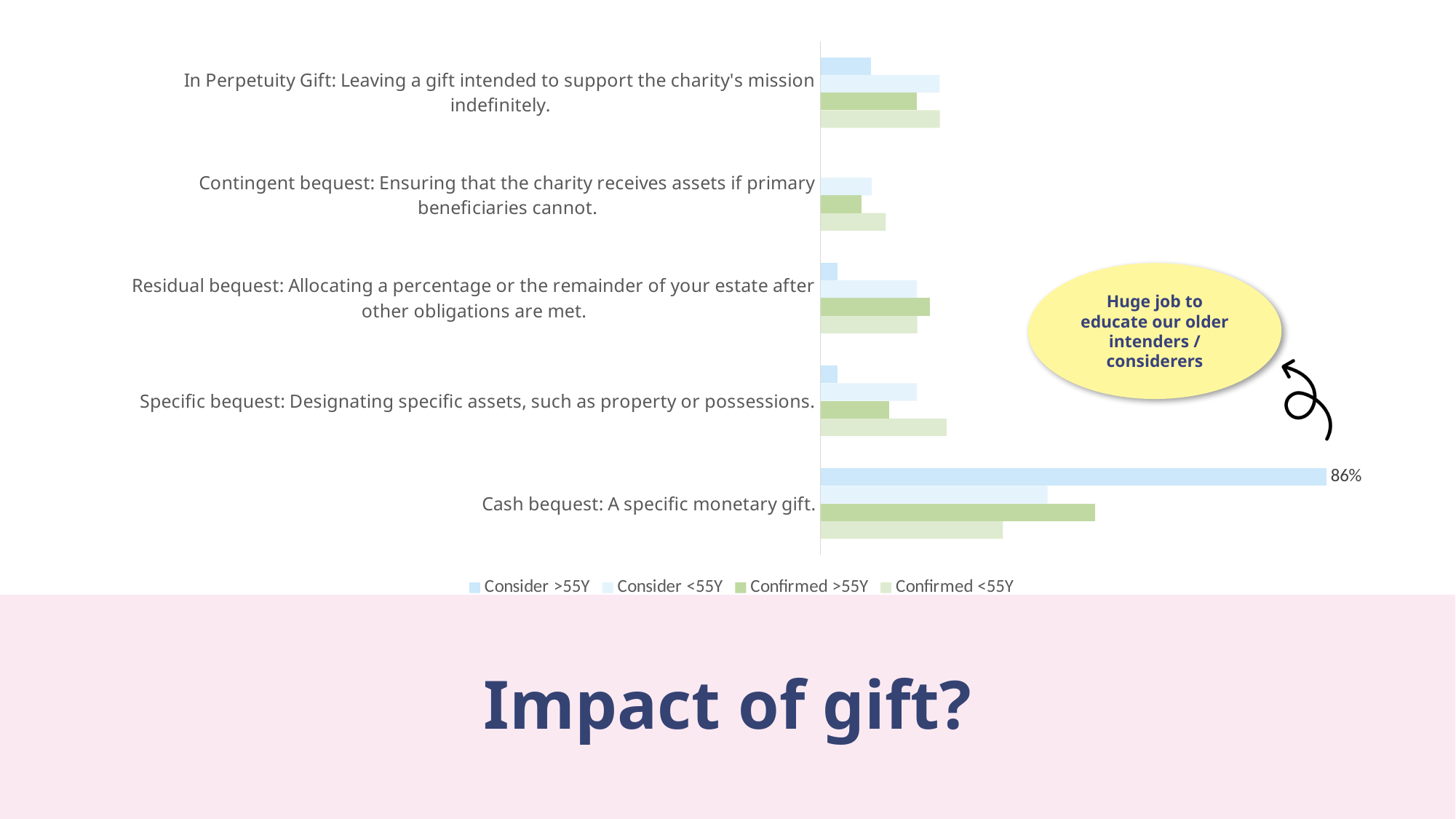
For Cash bequest, which is larger: Consider >55Y or Consider <55Y? Consider >55Y What is the Consider >55Y value for Cash bequest? 86% Which category has the shortest Confirmed >55Y bar? Contingent bequest How many series does the legend list? 4 What kind of chart is shown on the slide? Bar chart How many bequest categories are shown on the chart? 5 For In Perpetuity Gift, which is larger: Consider >55Y or Consider <55Y? Consider <55Y Which category has the longest Confirmed >55Y bar? Cash bequest For Specific bequest, which is larger: Confirmed >55Y or Confirmed <55Y? Confirmed <55Y Which category has the highest Consider >55Y value? Cash bequest What does the yellow callout on the slide say? Huge job to educate our older intenders / considerers